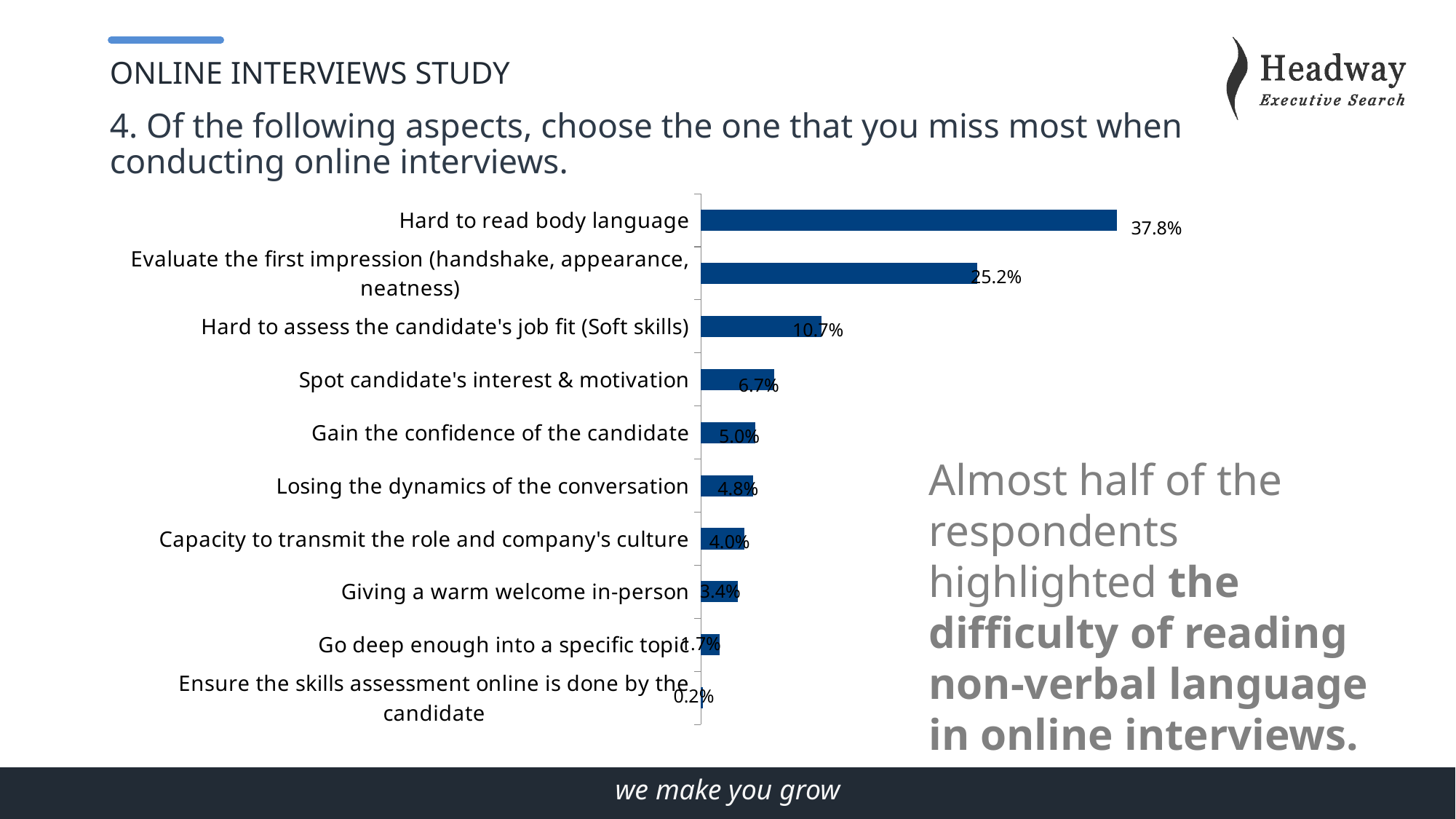
Which aspect has the highest percentage? Hard to read body language Which is larger: "Gain the confidence of the candidate" or "Capacity to transmit the role and company's culture"? Gain the confidence of the candidate How many aspects (categories) are shown in the chart? 10 What percentage of respondents chose "Hard to read body language"? 37.8% What colour are the bars in the chart? Dark blue What is the value for "Giving a warm welcome in-person"? 3.4% What is the difference between "Hard to assess the candidate's job fit (Soft skills)" and "Spot candidate's interest & motivation"? 4.0% What is the difference between "Hard to read body language" and "Evaluate the first impression (handshake, appearance, neatness)"? 12.6% What is the value for "Spot candidate's interest & motivation"? 6.7% What kind of chart is shown on the slide? Bar chart Which aspect has the lowest percentage? Ensure the skills assessment online is done by the candidate What is the value for "Evaluate the first impression (handshake, appearance, neatness)"? 25.2%